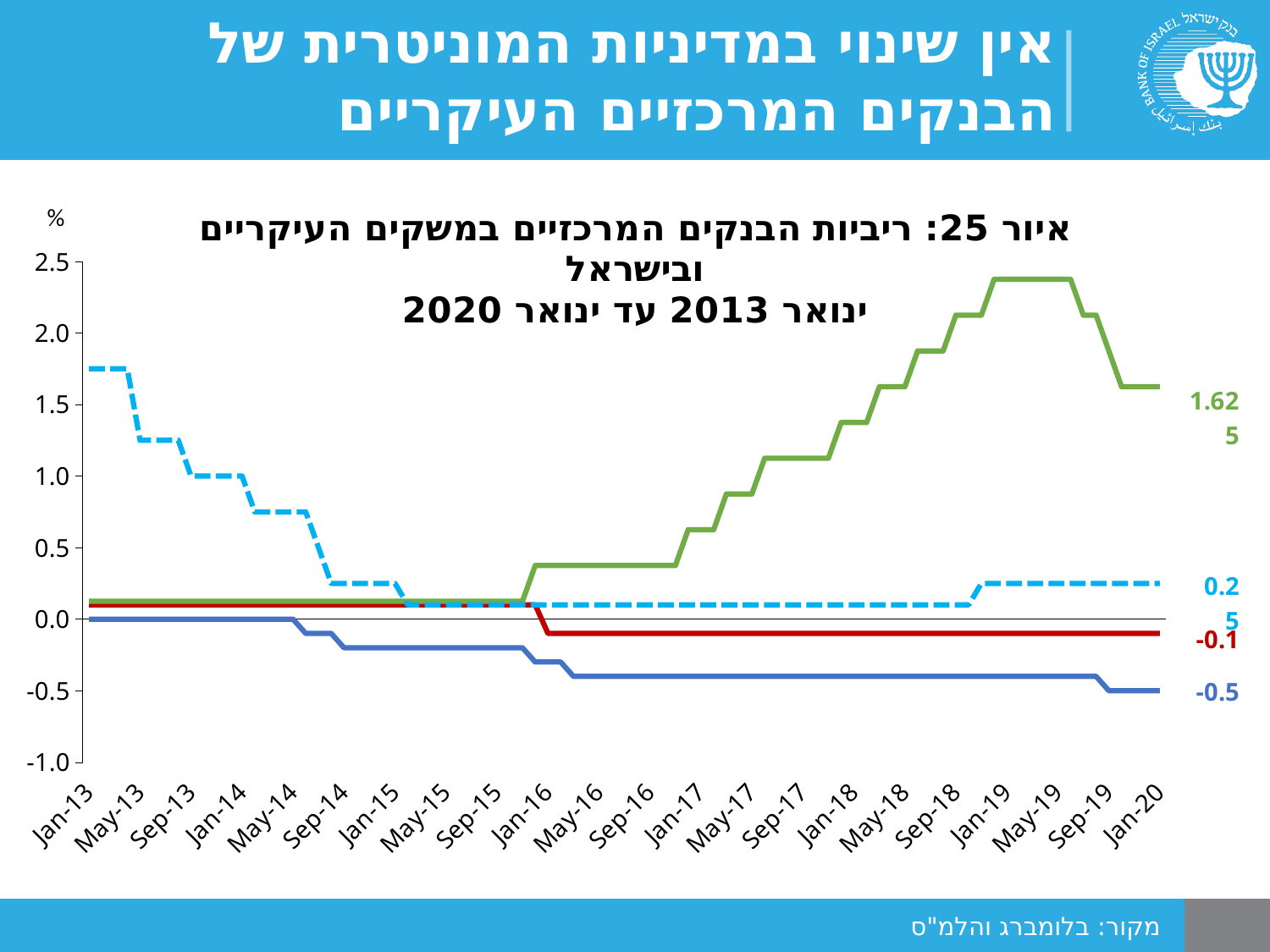
What unit is shown at the top of the vertical axis? % Is the value of the dashed blue line at Jan-13 greater or less than 1.5? greater Which line has the highest value at Jan-20? the green line Is the value of the green line at Jan-19 greater or less than 2.0? greater At Jan-20, which is larger: the value of the red line or the value of the solid blue line? the red line What is the difference between the end values of the red line (-0.1) and the solid blue line (-0.5)? 0.4 What value is labelled at the end of the solid blue line in Jan-20? -0.5 What value is labelled at the end of the red line in Jan-20? -0.1 Does the green line rise or fall between Jan-16 and Jan-19? rise Which line has the lowest value at Jan-20? the solid blue line What kind of chart is shown on the slide? line chart How many lines are plotted on the chart? 4